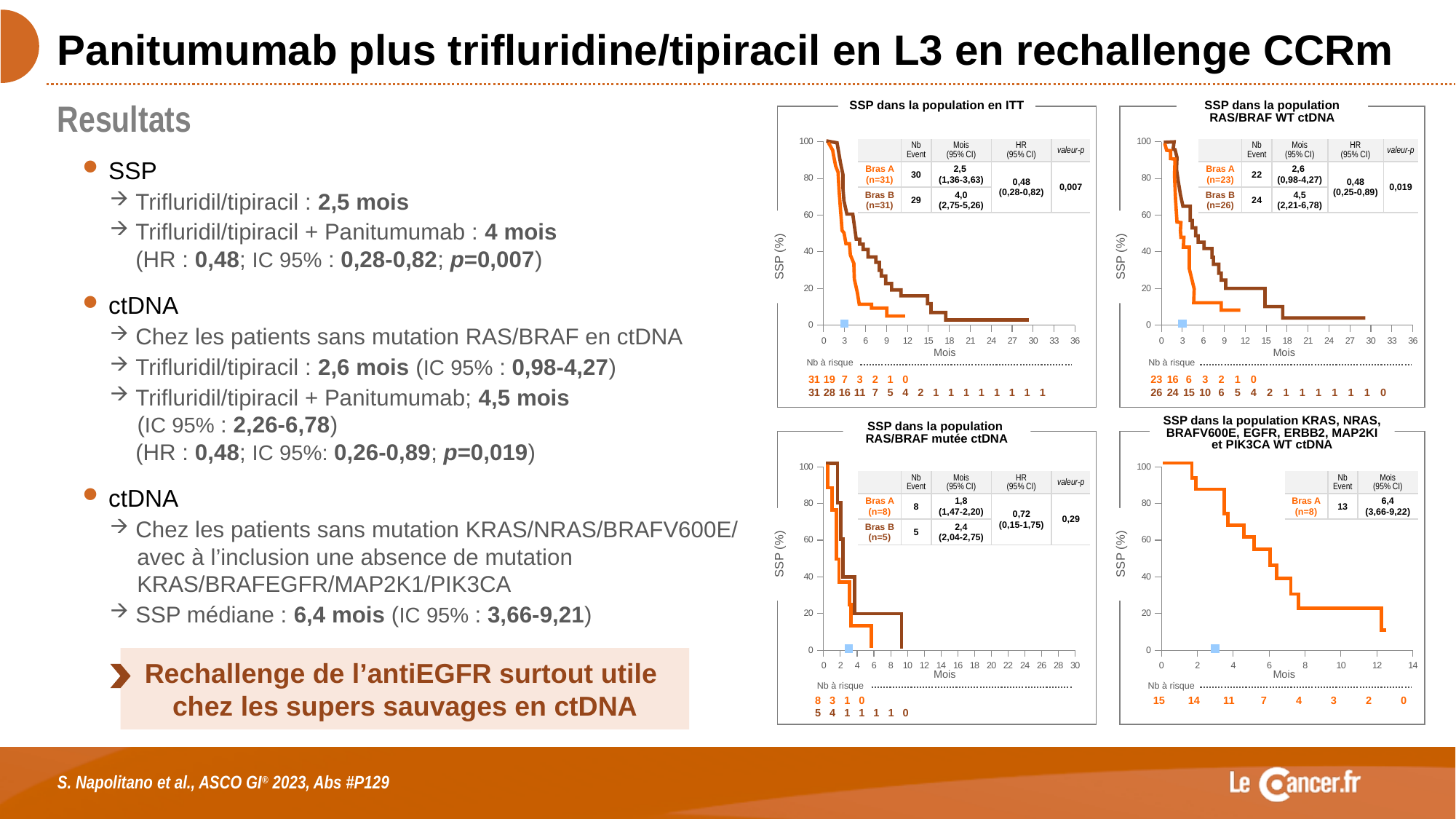
In the chart titled 'SSP dans la population en ITT', what is the HR (95% CI) shown in the table? 0,48 (0,28-0,82) In the chart titled 'SSP dans la population en ITT', what is the p-value shown? 0,007 In the chart titled 'SSP dans la population RAS/BRAF WT ctDNA', how many events are reported for Bras B (n=26)? 24 In the chart titled 'SSP dans la population en ITT', how many curves (arms) are plotted? 2 In the chart titled 'SSP dans la population en ITT', do the SSP curves rise or fall as months increase? fall In the bottom-right chart (KRAS, NRAS, BRAFV600E, EGFR, ERBB2, MAP2KI et PIK3CA WT ctDNA), how many patients are at risk at month 6? 7 In the chart titled 'SSP dans la population RAS/BRAF WT ctDNA', which arm has the longer median SSP, Bras A or Bras B? Bras B In the chart titled 'SSP dans la population en ITT', what is the median SSP in months for Bras A (n=31)? 2,5 In the chart titled 'SSP dans la population RAS/BRAF mutée ctDNA', what is the p-value shown? 0,29 In the chart titled 'SSP dans la population RAS/BRAF mutée ctDNA', what is the median SSP (95% CI) for Bras B (n=5)? 2,4 (2,04-2,75) In the chart titled 'SSP dans la population en ITT', what is the difference in median months between Bras B and Bras A? 1,5 In the bottom-right chart (KRAS, NRAS, BRAFV600E, EGFR, ERBB2, MAP2KI et PIK3CA WT ctDNA), what is the median SSP (95% CI) for Bras A? 6,4 (3,66-9,22)